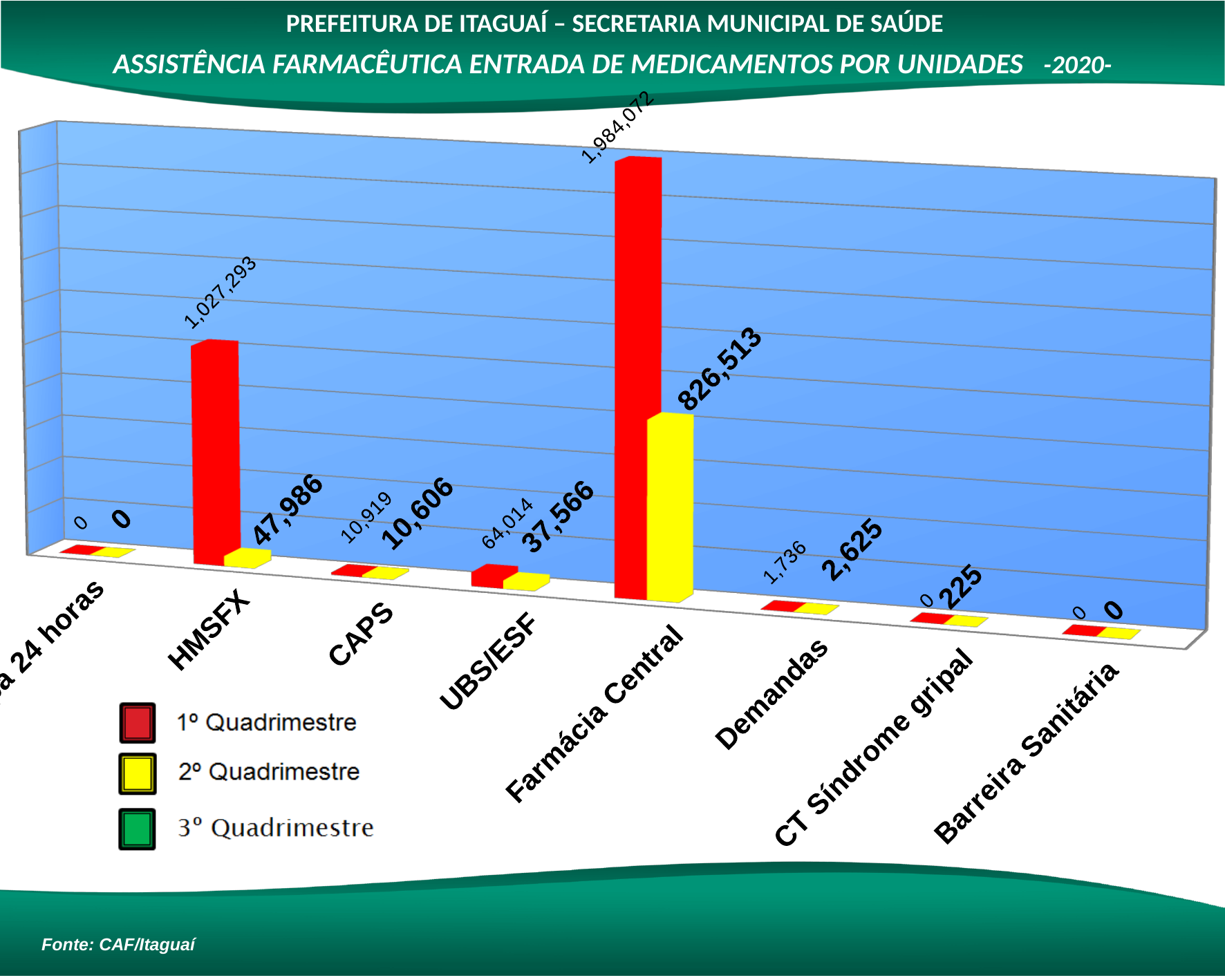
What is the 1º Quadrimestre value for Farmácia Central? 1,984,072 What is the difference between the 1º Quadrimestre and 2º Quadrimestre values for Farmácia Central? 1,157,559 What is the 2º Quadrimestre value for HMSFX? 47,986 How many series does the legend list? 3 What is the 1º Quadrimestre value for UBS/ESF? 64,014 Which category has the highest 1º Quadrimestre value? Farmácia Central What is the 2º Quadrimestre value for CT Síndrome gripal? 225 What is the 2º Quadrimestre value for Demandas? 2,625 What is the difference between the 1º Quadrimestre and 2º Quadrimestre values for CAPS? 313 What kind of chart is shown on the slide? Bar chart What colour represents 2º Quadrimestre in the legend? Yellow Which is larger for Demandas: the 1º Quadrimestre value or the 2º Quadrimestre value? 2º Quadrimestre